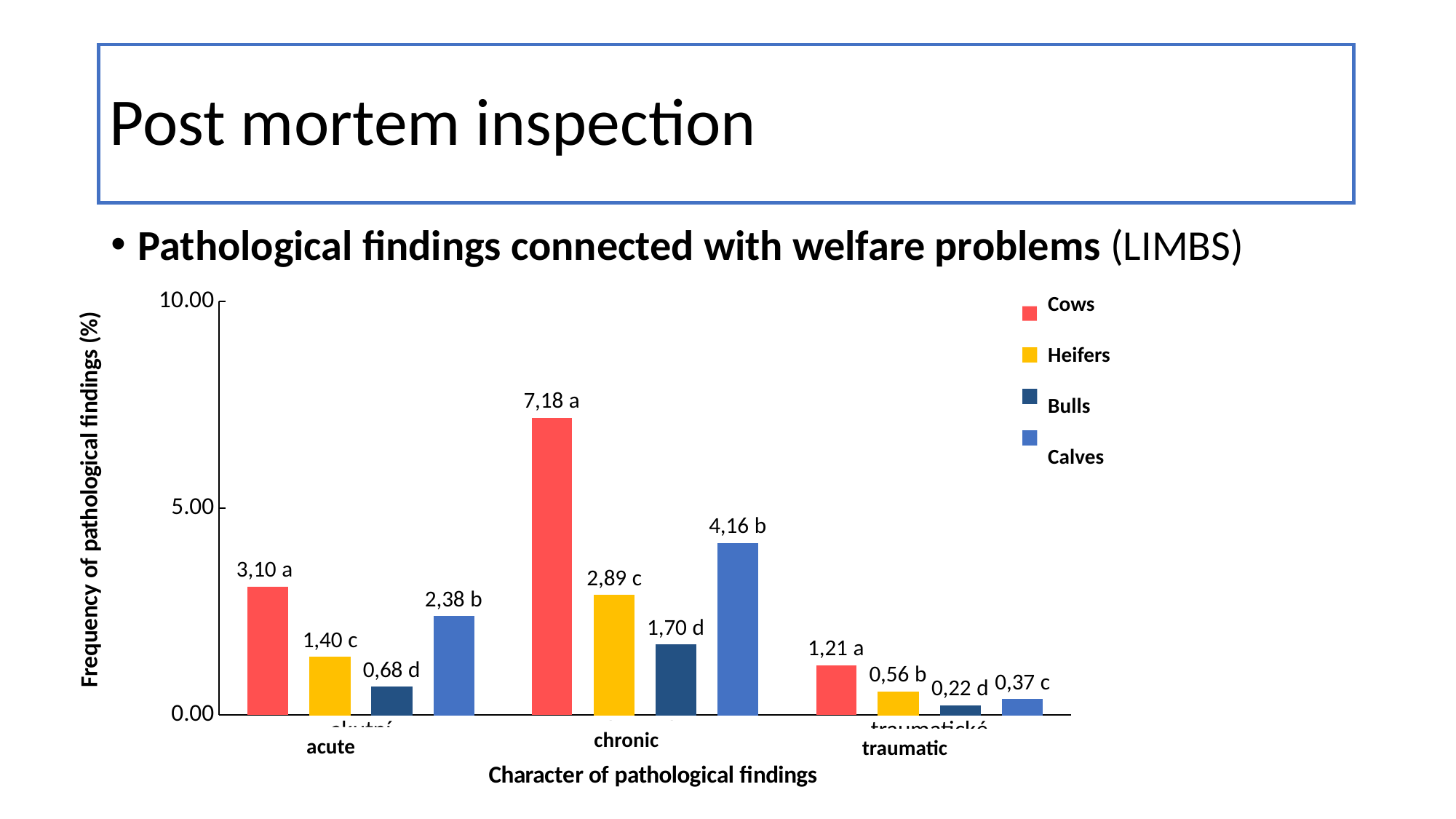
What is the value for Heifers in the chronic category? 2,89 What is the difference between the Cows values for chronic and acute findings? 4,08 How many categories are shown on the x axis? 3 What is the value for Calves in the acute category? 2,38 How many series does the legend list? 4 Which series has the lowest value in the acute category? Bulls What kind of chart is shown on the slide? Bar chart Which is larger: the Heifers value for acute or the Cows value for traumatic? Heifers value for acute What is the value for Bulls in the traumatic category? 0,22 Which series has the highest value in the chronic category? Cows What is the difference between the Calves values for chronic and acute findings? 1,78 What is the frequency of pathological findings for Cows in the chronic category? 7,18